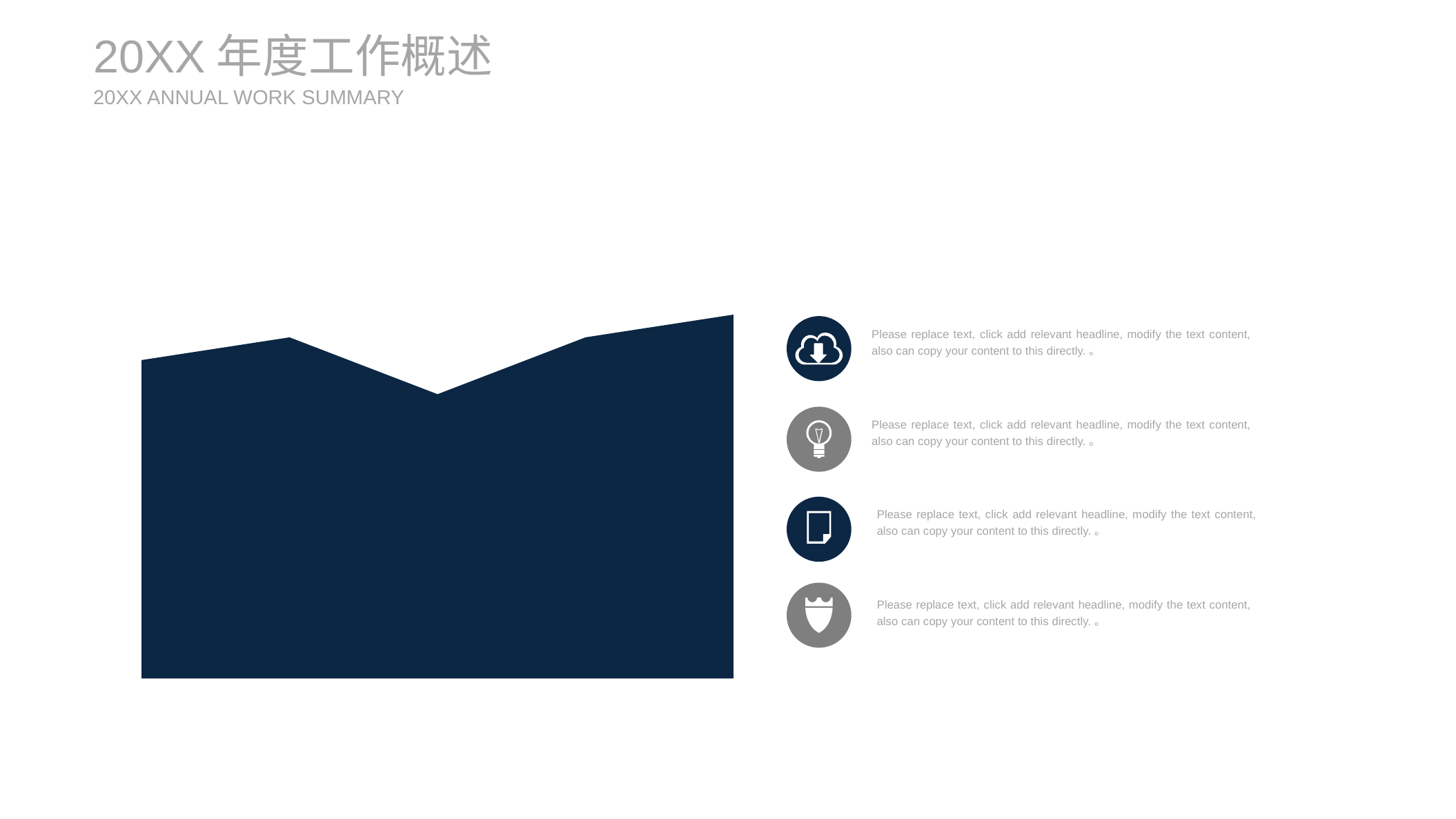
What colour is the filled area of the chart? dark navy blue What kind of chart is shown on the left of the slide? area chart Which point of the area chart is the lowest: the first, the middle, or the last? the middle Does the area chart show any axis labels or data labels? No How many data points does the area chart's outline have? 5 Does the area chart end higher or lower than it starts, reading left to right? higher Is the right end of the area chart higher or lower than the left end? higher Which point of the area chart is the highest: the first, the middle, or the last? the last